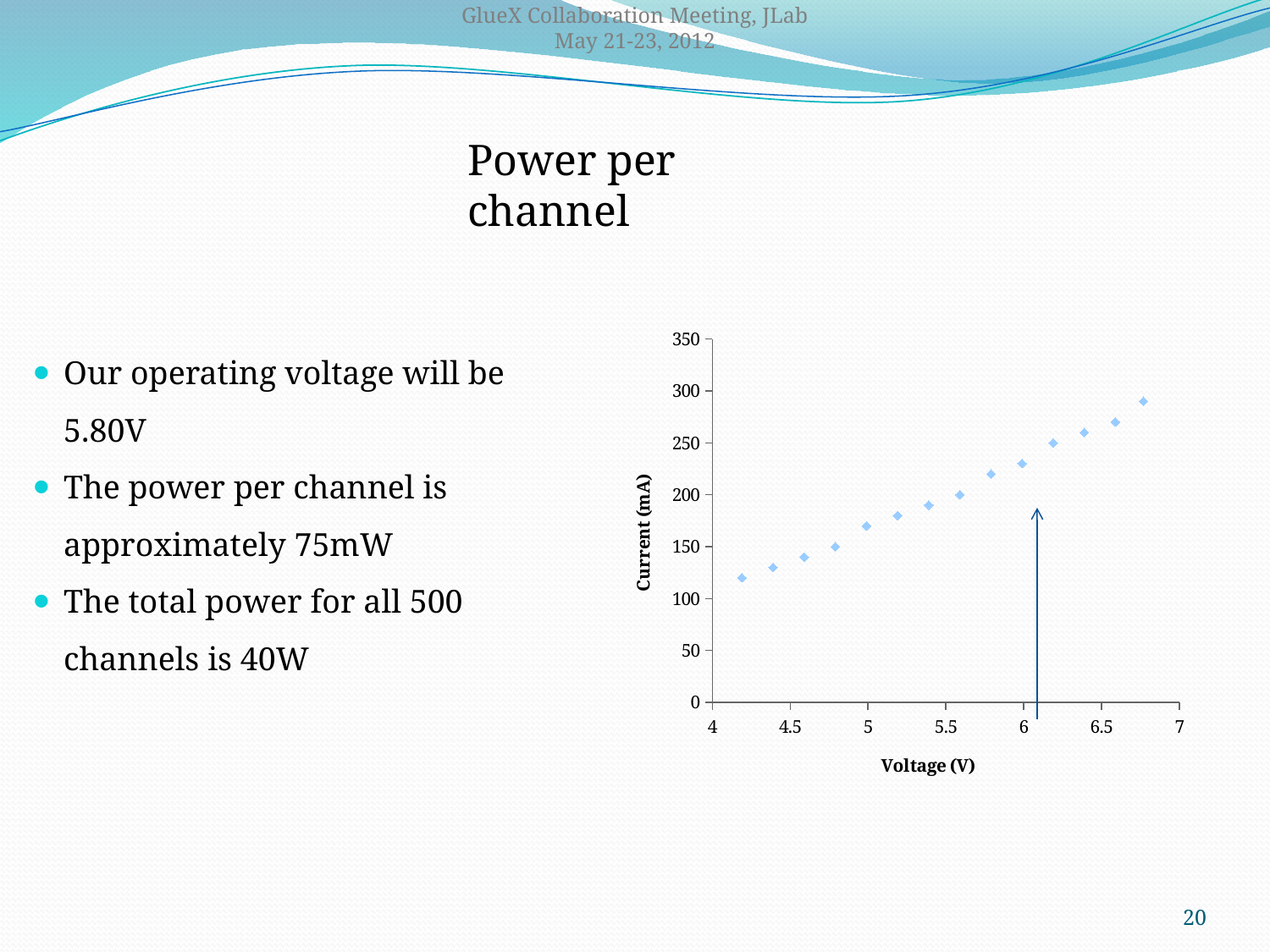
Is the current at 6 V greater or less than 200 mA? greater Is the current at the highest plotted voltage greater or less than 300 mA? less Which has the larger current, the point at 5 V or the point at 6 V? 6 V Is the current at the lowest plotted voltage greater or less than 150 mA? less How many data points are plotted on the chart? 14 Does the current rise or fall as the voltage increases along the x axis? rise What is the title of the y axis of the chart? Current (mA) What is the title of the x axis of the chart? Voltage (V) What kind of chart is shown on the slide? scatter chart